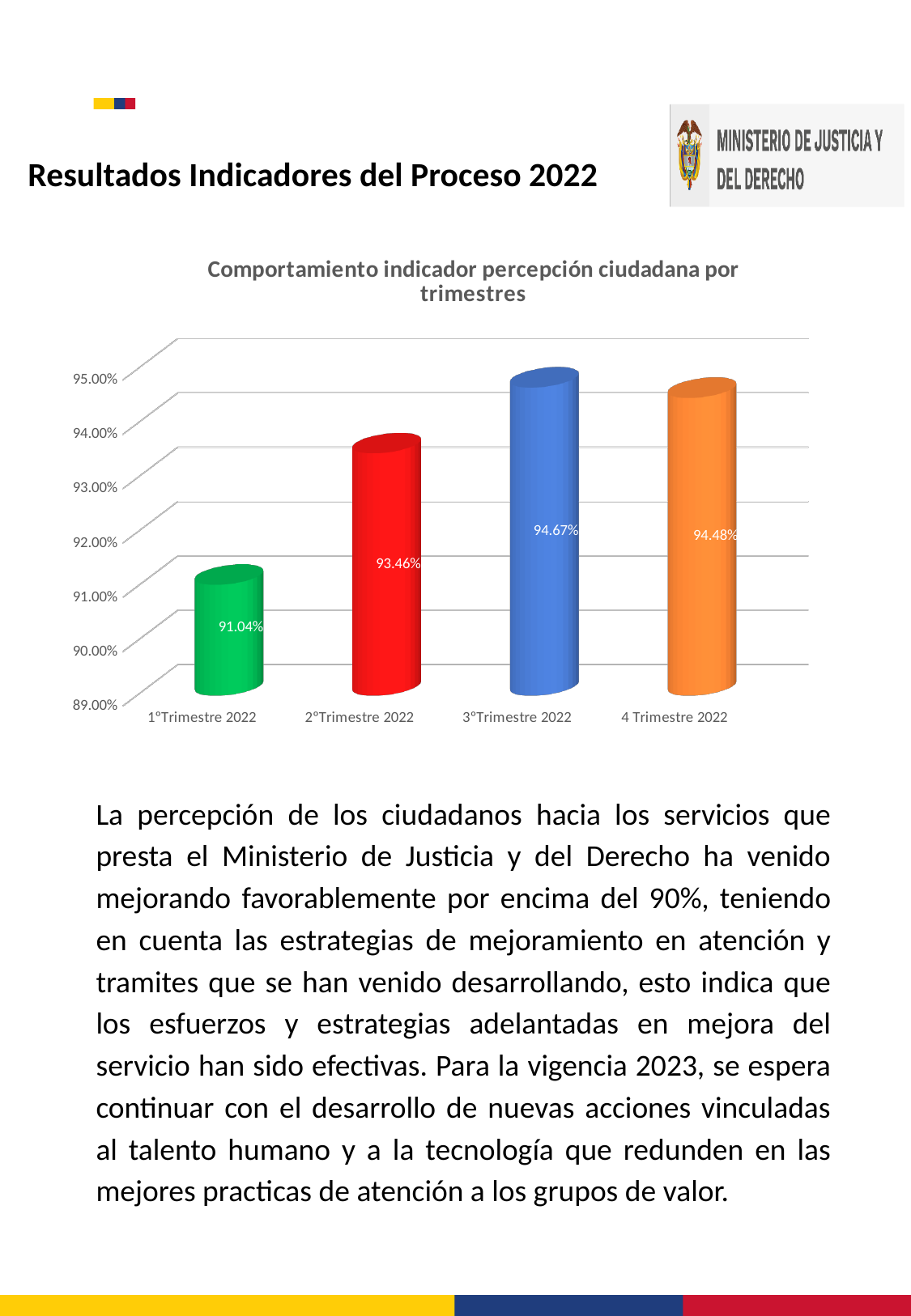
How many trimesters are shown on the chart? 4 Which trimester has the highest value? 3°Trimestre 2022 Which trimester has the lowest value? 1°Trimestre 2022 What is the value for 2°Trimestre 2022? 93.46% Which is larger, the value for 2°Trimestre 2022 or the value for 4 Trimestre 2022? 4 Trimestre 2022 What kind of chart is shown on the slide? bar chart What is the value for 4 Trimestre 2022? 94.48% What is the difference between the values for 2°Trimestre 2022 and 1°Trimestre 2022? 2.42% What is the difference between the values for 3°Trimestre 2022 and 1°Trimestre 2022? 3.63% Is the value for 1°Trimestre 2022 greater or less than 92.00%? less What is the value for 1°Trimestre 2022? 91.04% What is the value for 3°Trimestre 2022? 94.67%